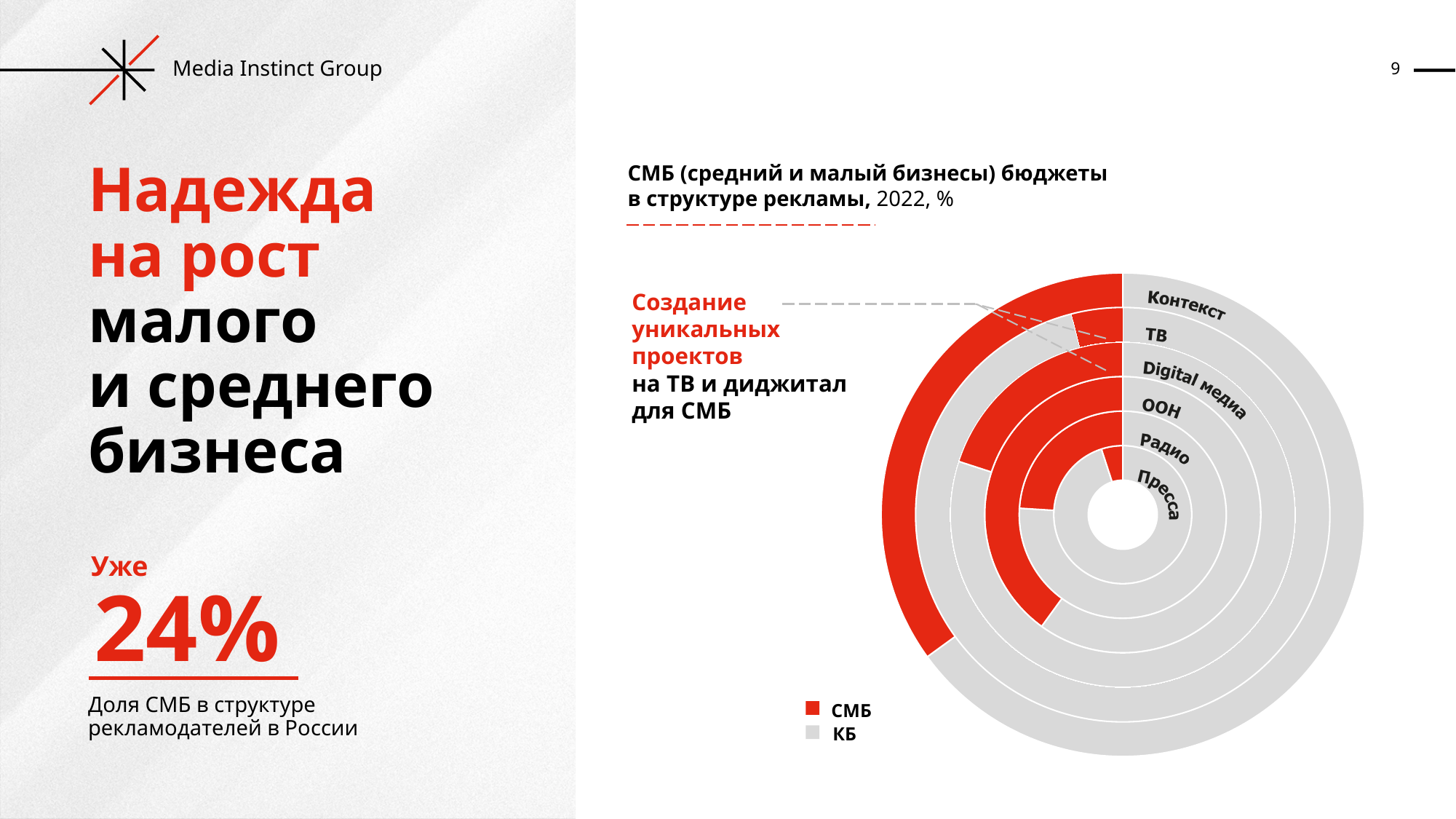
Which has a larger СМБ share in the chart: Контекст or Пресса? Контекст How many series does the chart legend list? 2 Which media category has the largest СМБ share in the chart? OOH Which media category is represented by the outermost ring of the chart? Контекст Which colour represents СМБ in the chart? Red Which year does the chart title refer to? 2022 Which has a larger СМБ share in the chart: ТВ or Радио? Радио How many media categories (rings) are shown in the chart? 6 What kind of chart is shown on the slide? Doughnut (concentric ring) chart